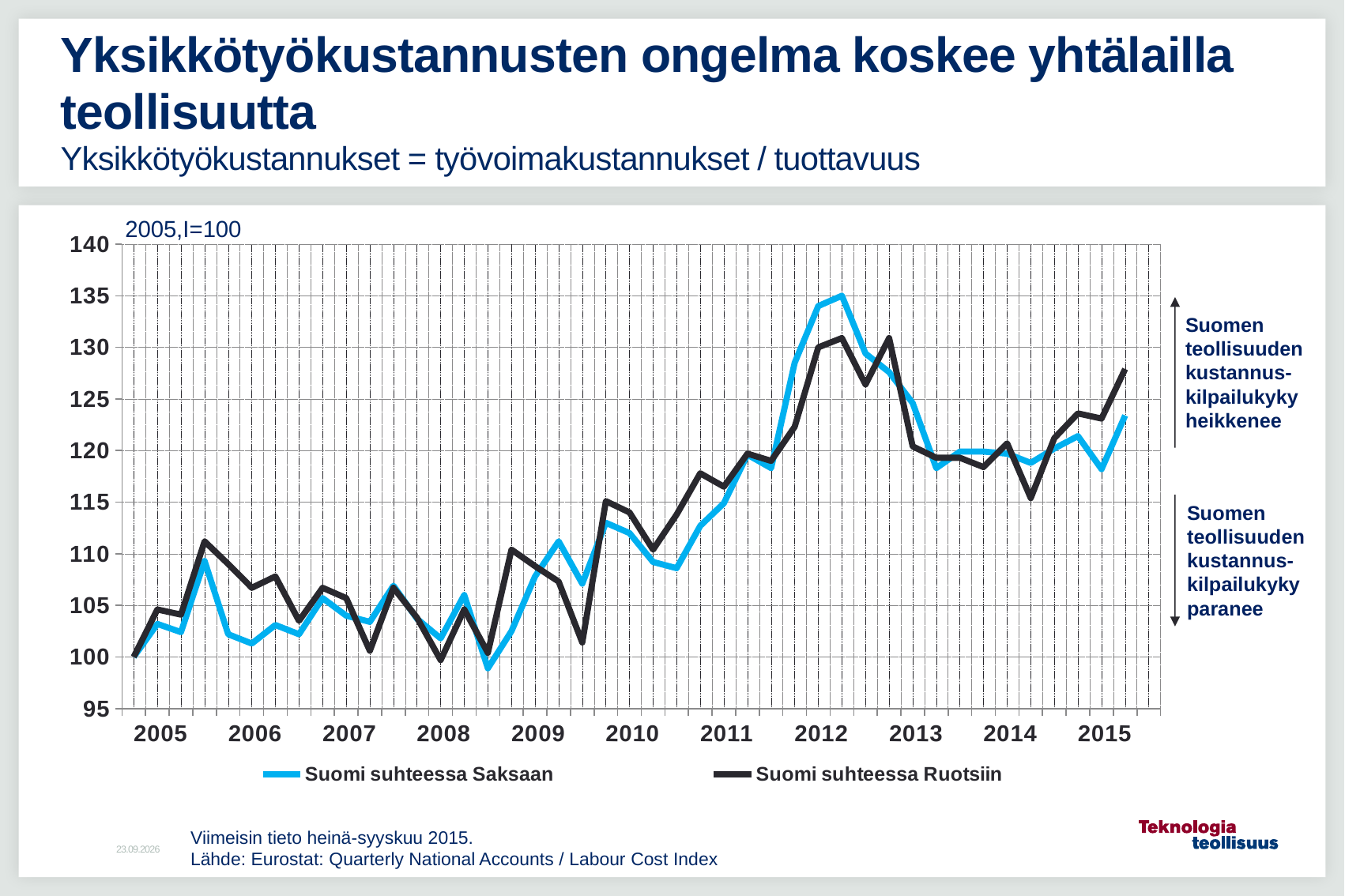
What kind of chart is shown on the slide? line chart Do the values of Suomi suhteessa Saksaan rise or fall between 2008 and 2012? rise Is the value of Suomi suhteessa Ruotsiin at the end of 2015 greater or less than 125? greater At the 2012 peak, which series is higher: Suomi suhteessa Saksaan or Suomi suhteessa Ruotsiin? Suomi suhteessa Saksaan Which series reaches the highest value on the chart? Suomi suhteessa Saksaan At the last point in 2015, which series is higher: Suomi suhteessa Saksaan or Suomi suhteessa Ruotsiin? Suomi suhteessa Ruotsiin Is the peak value of Suomi suhteessa Saksaan in 2012 greater or less than 130? greater How many years are labelled on the x axis? 11 How many series does the legend list? 2 Is the value of Suomi suhteessa Saksaan at the end of 2015 greater or less than 125? less What is the index base stated above the chart? 2005,I=100 Which series is drawn in blue? Suomi suhteessa Saksaan